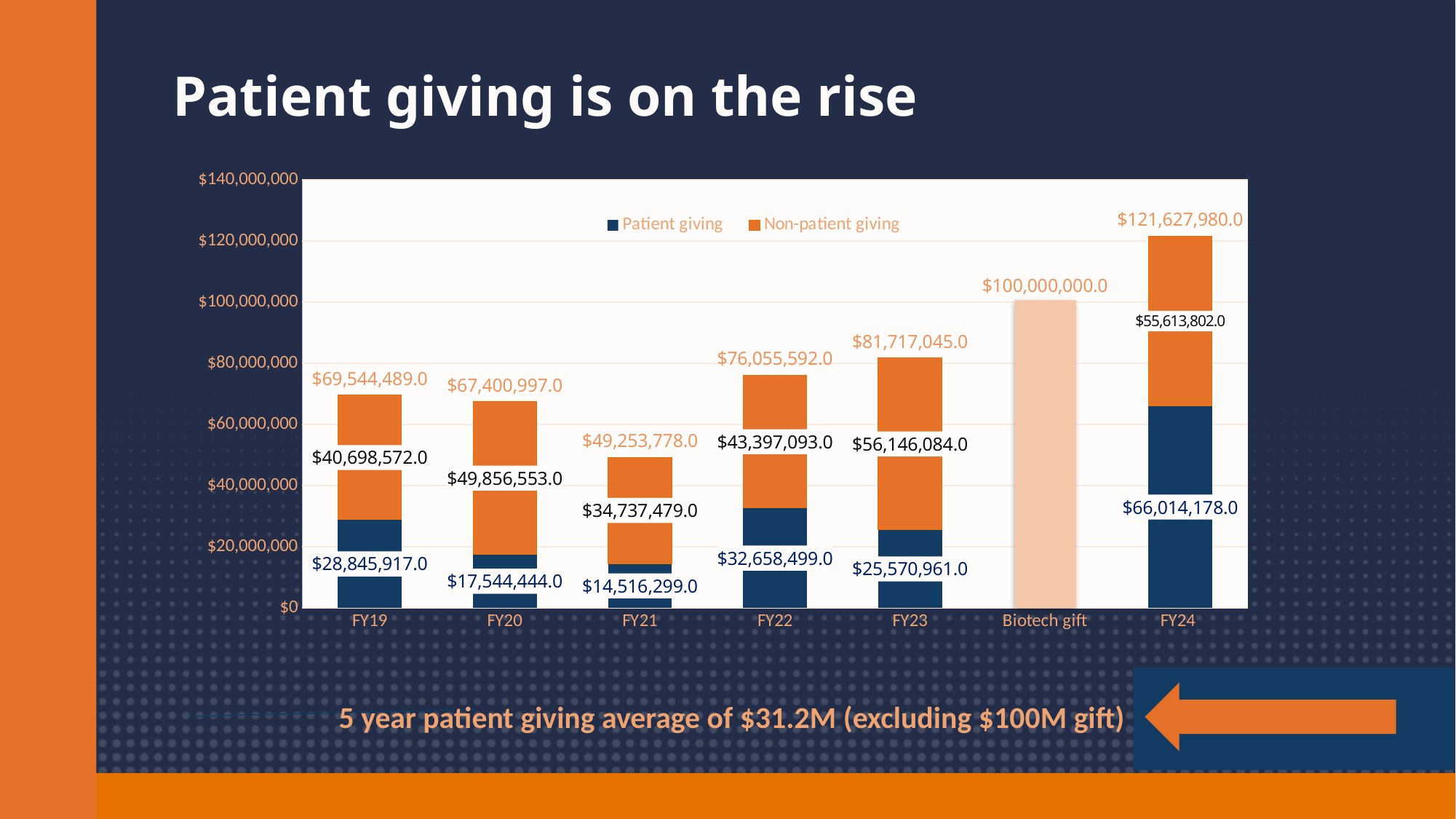
How many series does the legend list? 2 What kind of chart is shown on the slide? Stacked bar chart What is the total of the stacked bar for FY22? $76,055,592.0 Which fiscal year has the lowest Patient giving value? FY21 How many categories are shown on the x axis? 7 What is the value shown for the Biotech gift bar? $100,000,000.0 What is the Non-patient giving value for FY23? $56,146,084.0 Which fiscal year has the highest Patient giving value? FY24 What is the Patient giving value for FY24? $66,014,178.0 What is the difference between Patient giving in FY24 and Patient giving in FY23? $40,443,217.0 Which is larger, Patient giving in FY19 or Patient giving in FY20? FY19 What is the title of the slide? Patient giving is on the rise